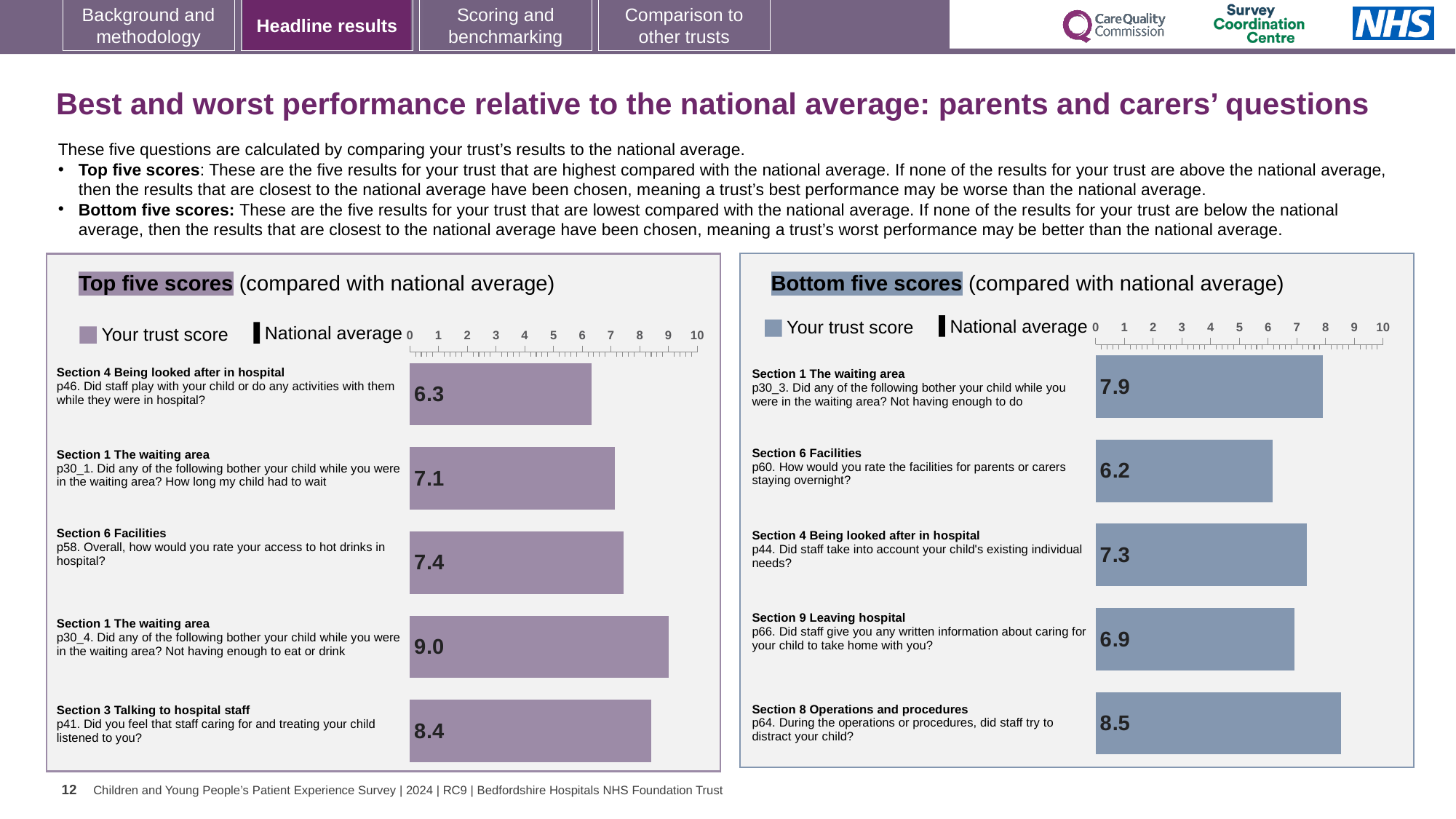
In the 'Bottom five scores' chart, which question has the lowest trust score? p60 (facilities for parents or carers staying overnight), 6.2 In the 'Top five scores' chart, what is the difference between the trust scores for p30_4 and p46? 2.7 In the 'Bottom five scores' chart, which has the larger trust score: p30_3 (Not having enough to do) or p66 (written information about caring for your child)? p30_3 (7.9) What type of chart is the 'Bottom five scores' chart? Bar chart How many bars are plotted in the 'Top five scores' chart? 5 In the 'Top five scores' chart, which question has the highest trust score? p30_4 (Not having enough to eat or drink), 9.0 In the 'Bottom five scores' chart, what is the difference between the trust scores for p64 and p60? 2.3 In the 'Top five scores' chart, what is the trust score for p30_4 (Not having enough to eat or drink)? 9.0 In the 'Bottom five scores' chart, what is the trust score for p60 (How would you rate the facilities for parents or carers staying overnight?)? 6.2 In the 'Top five scores' chart, which question has the lowest trust score? p46 (Did staff play with your child or do any activities with them while they were in hospital?), 6.3 In the 'Bottom five scores' chart, which question has the highest trust score? p64 (During the operations or procedures, did staff try to distract your child?), 8.5 In the 'Top five scores' chart, what is the trust score for p46 (Did staff play with your child or do any activities with them while they were in hospital?)? 6.3